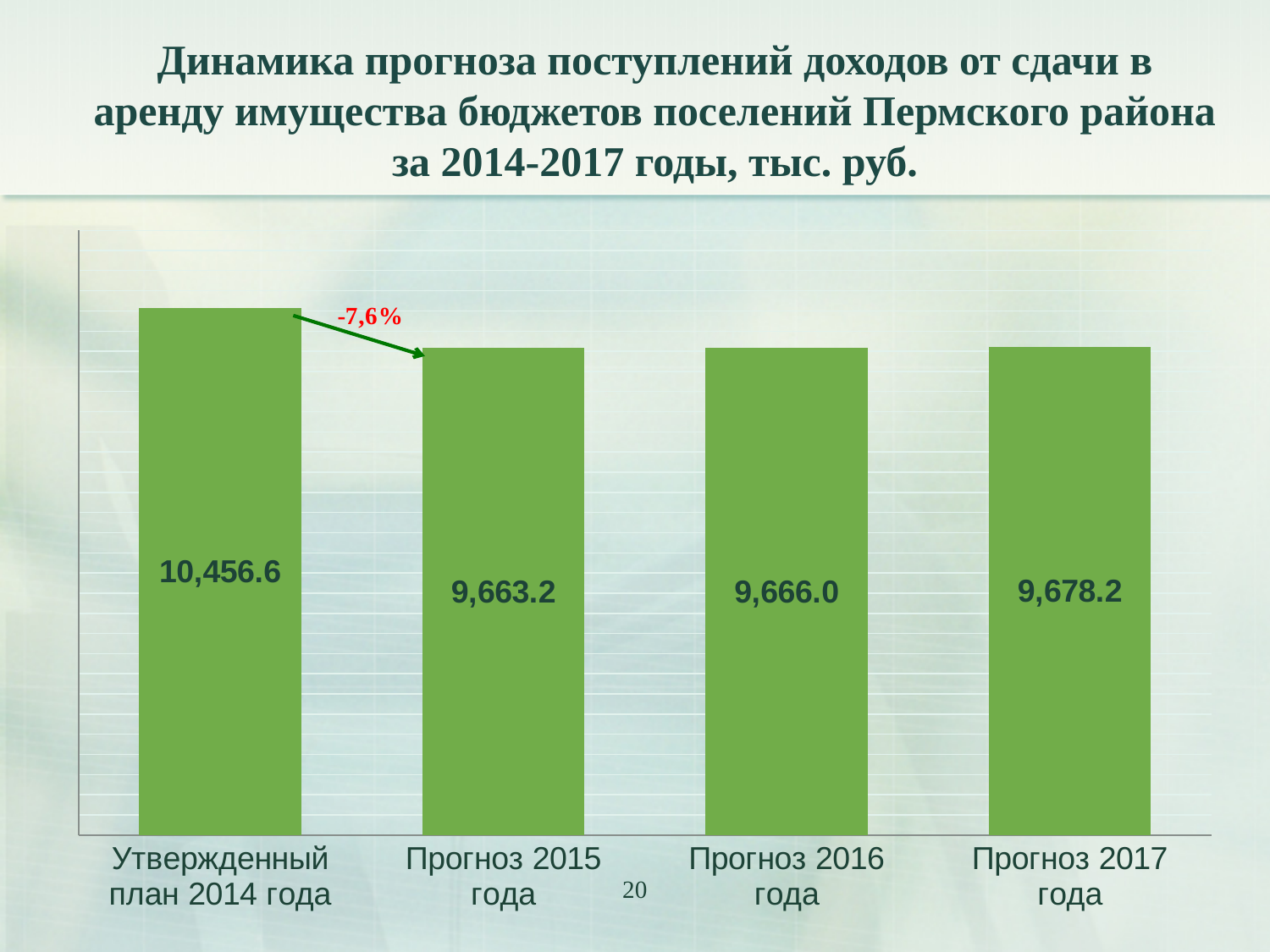
What is the value for Утвержденный план 2014 года? 10,456.6 What is the difference between the value for Прогноз 2017 года and the value for Прогноз 2016 года? 12.2 Which is larger, the value for Утвержденный план 2014 года or the value for Прогноз 2015 года? Утвержденный план 2014 года What is the value for Прогноз 2015 года? 9,663.2 What kind of chart is shown on the slide? bar chart What percentage change is written next to the arrow between the 2014 plan and the 2015 forecast? -7,6% What is the value for Прогноз 2017 года? 9,678.2 Which category has the highest value? Утвержденный план 2014 года What is the value for Прогноз 2016 года? 9,666.0 Which category has the lowest value according to the data labels? Прогноз 2015 года How many categories are shown on the x axis? 4 What is the difference between the value for Утвержденный план 2014 года and the value for Прогноз 2015 года? 793.4